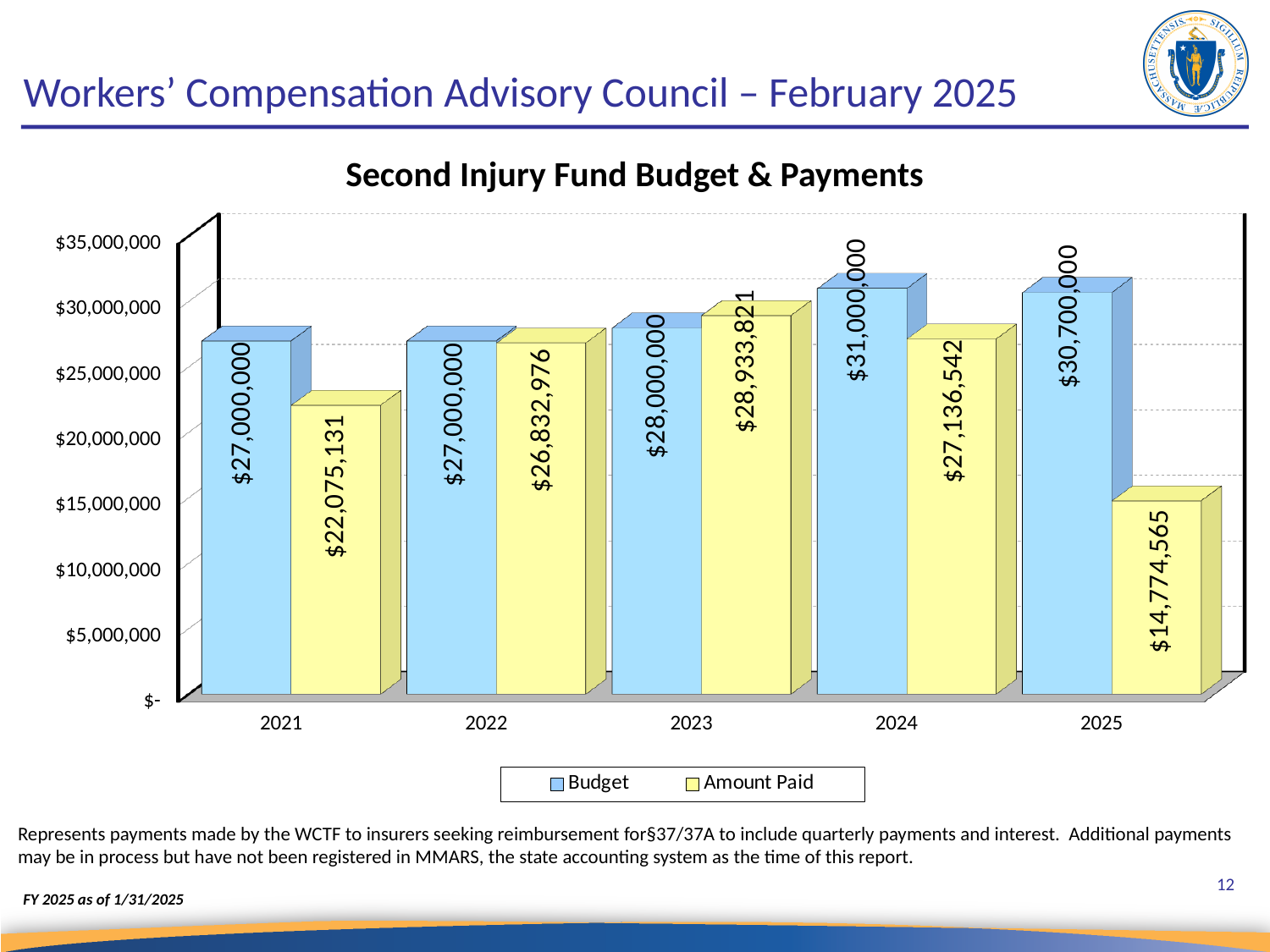
By how much does the Amount Paid exceed the Budget in 2023? $933,821 How many series does the legend list? 2 What is the Amount Paid for 2025? $14,774,565 What is the Budget value for 2024? $31,000,000 What kind of chart is shown on the slide? Bar chart Which year has the highest Budget? 2024 Which year has the lowest Amount Paid? 2025 How many years are shown on the x axis? 5 What is the title of the chart? Second Injury Fund Budget & Payments In 2024, which is larger, the Budget or the Amount Paid? Budget What is the Amount Paid for 2022? $26,832,976 What is the difference between the Budget and the Amount Paid in 2021? $4,924,869